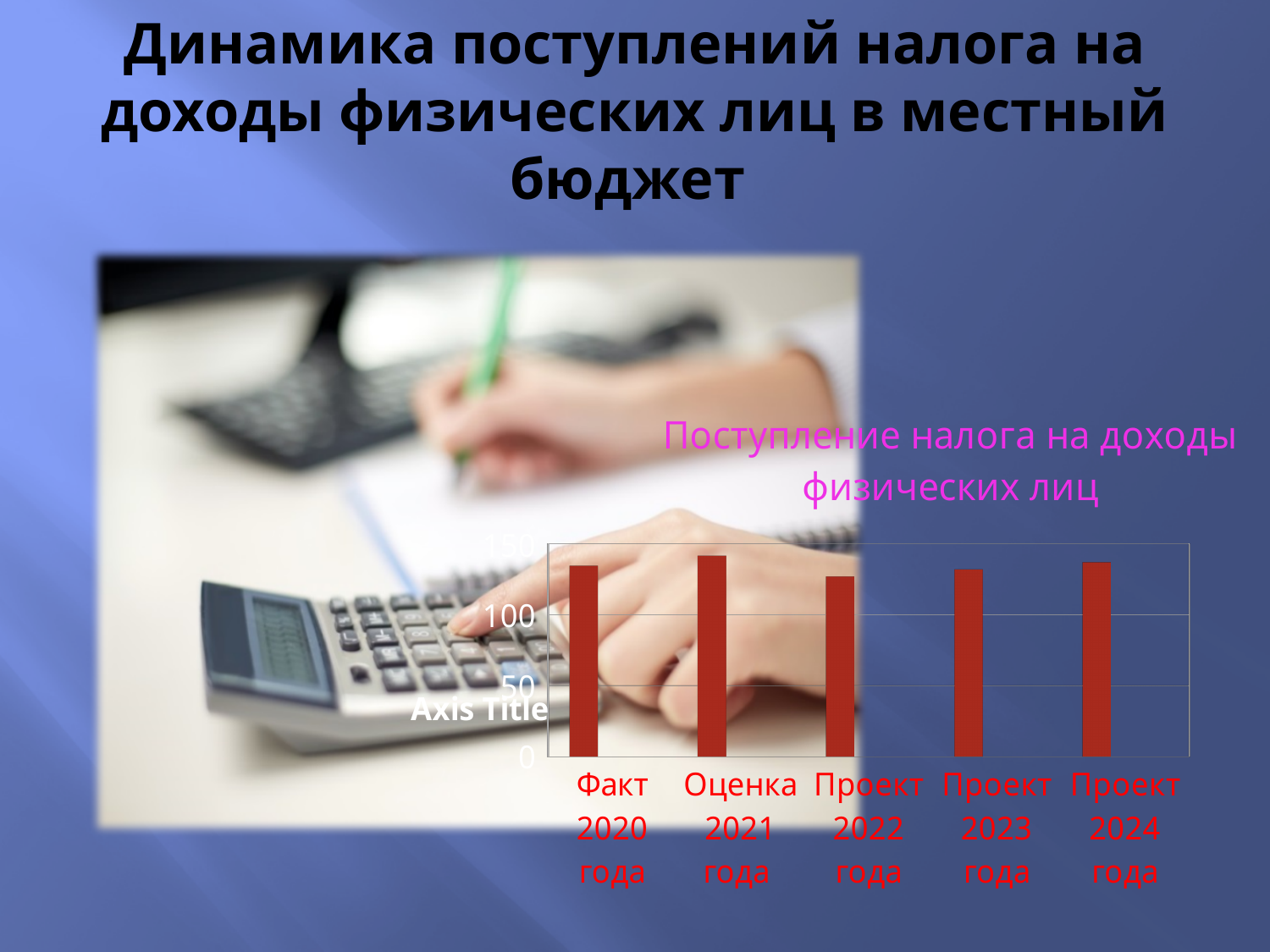
Which category is the first (leftmost) on the x axis? Факт 2020 года Is the value for Оценка 2021 года greater or less than 150? less Which category is the last (rightmost) on the x axis? Проект 2024 года Is the value for Факт 2020 года greater or less than 100? greater What kind of chart is shown on the slide? bar chart What is the highest value shown on the vertical axis? 150 Is the value for Проект 2023 года greater or less than 150? less What is the title of the chart? Поступление налога на доходы физических лиц How many categories (bars) does the chart show? 5